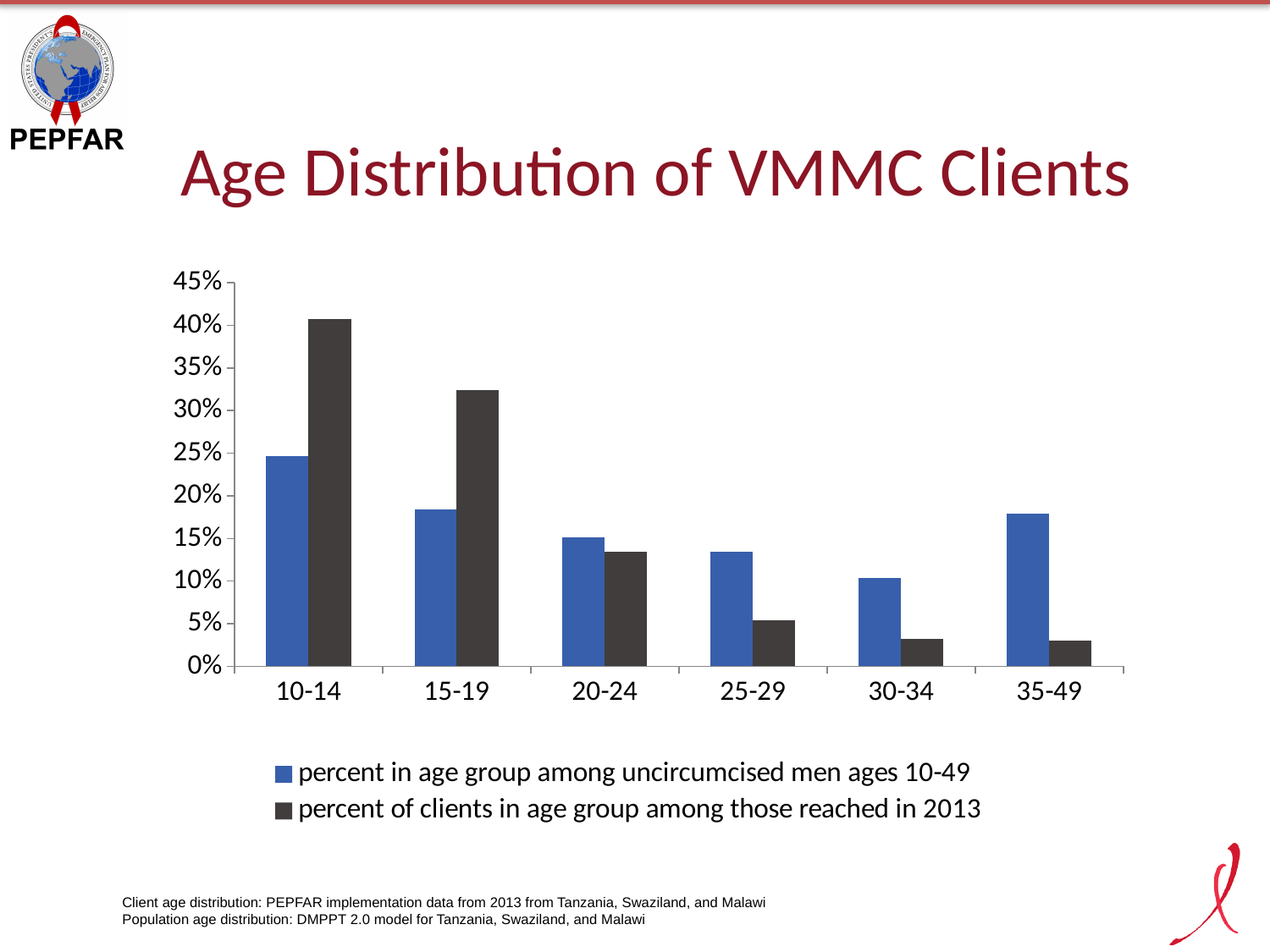
For the 35-49 age group, which series has the larger value: percent in age group among uncircumcised men ages 10-49 or percent of clients in age group among those reached in 2013? percent in age group among uncircumcised men ages 10-49 Is the value for percent of clients in age group among those reached in 2013 for 10-14 greater or less than 35%? greater Which age group has the highest value for percent of clients in age group among those reached in 2013? 10-14 Is the value for percent of clients in age group among those reached in 2013 for 25-29 greater or less than 10%? less How many age groups are shown on the x axis? 6 Which age group has the highest value for percent in age group among uncircumcised men ages 10-49? 10-14 How many series does the legend list? 2 What kind of chart is shown on the slide? bar chart What is the title of the chart? Age Distribution of VMMC Clients Is the value for percent in age group among uncircumcised men ages 10-49 for 10-14 greater or less than 20%? greater Do the values for percent of clients in age group among those reached in 2013 rise or fall as age group increases along the x axis? fall Which age group has the lowest value for percent in age group among uncircumcised men ages 10-49? 30-34